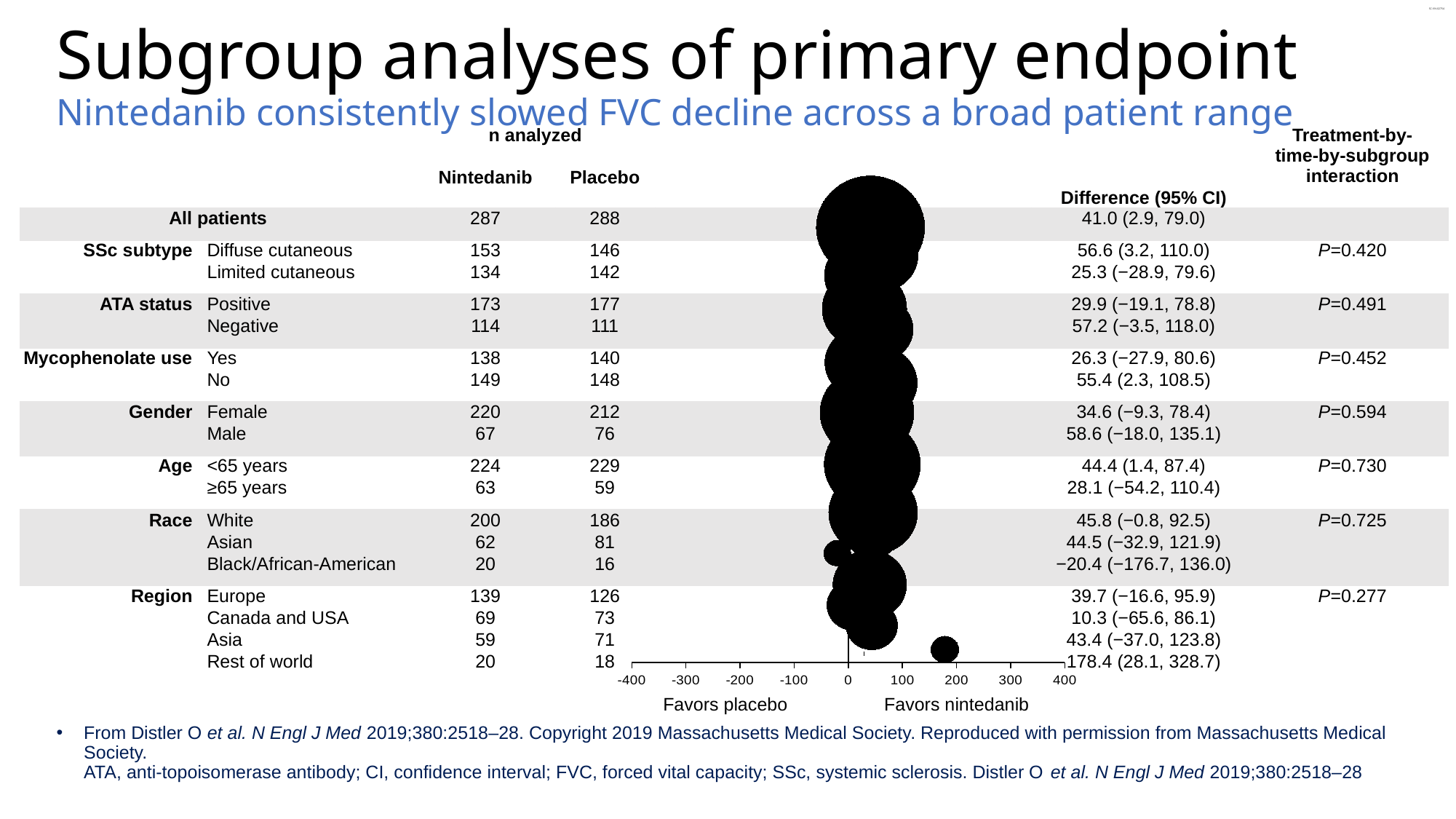
Is the point estimate for the Black/African-American subgroup greater or less than 0? less What are the minimum and maximum values shown on the x axis of the forest plot? -400 and 400 Which subgroup has the largest point estimate for the difference? Rest of world What is the treatment-by-time-by-subgroup interaction P value for Region? P=0.277 What is the point estimate of the difference for the Rest of world region subgroup? 178.4 What kind of chart is shown on the slide? Forest plot What is the difference (95% CI) shown for All patients? 41.0 (2.9, 79.0) What is the difference between the point estimates for Diffuse cutaneous (56.6) and Limited cutaneous (25.3)? 31.3 Which has the larger point estimate difference, Diffuse cutaneous or Limited cutaneous? Diffuse cutaneous Is the point estimate for the Rest of world subgroup greater or less than 100? greater Which subgroup has the lowest point estimate for the difference? Black/African-American How many subgroup rows (including All patients) are plotted in the forest plot? 18